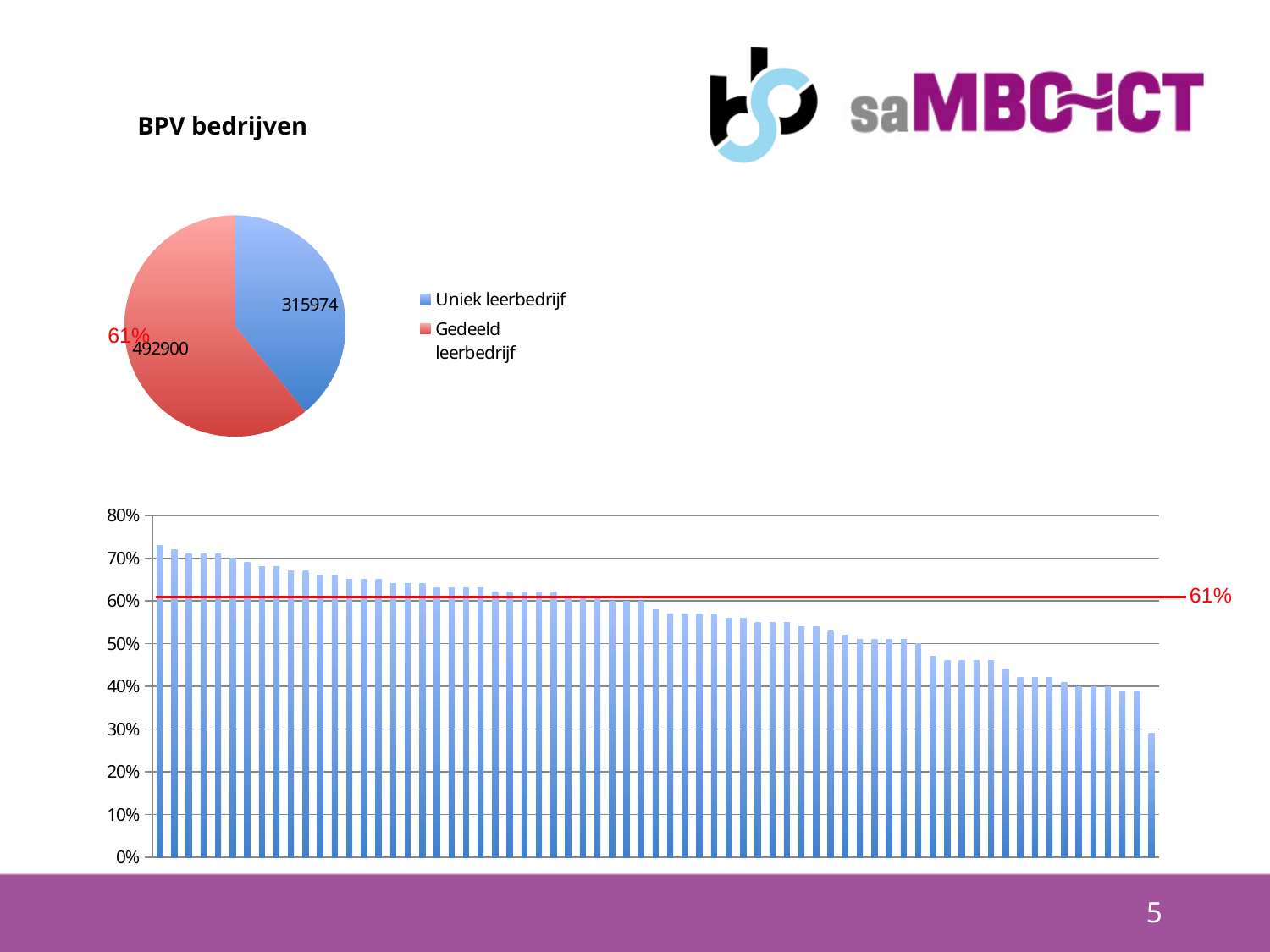
In the bar chart at the bottom of the slide, what value is marked by the red horizontal line? 61% In the bar chart at the bottom of the slide, do the values rise or fall from left to right? Fall How many entries does the legend of the pie chart list? 2 In the bar chart at the bottom of the slide, is the value of the leftmost bar greater or less than 70%? greater What kind of chart is the chart at the bottom of the slide? Bar chart In the pie chart, what colour is the Uniek leerbedrijf slice? Blue In the pie chart, what percentage share is printed next to the Gedeeld leerbedrijf slice? 61% In the pie chart, which slice is larger, Uniek leerbedrijf or Gedeeld leerbedrijf? Gedeeld leerbedrijf In the pie chart, what is the value for Gedeeld leerbedrijf? 492900 In the pie chart, what is the value for Uniek leerbedrijf? 315974 In the pie chart, what is the difference between the Gedeeld leerbedrijf value and the Uniek leerbedrijf value? 176926